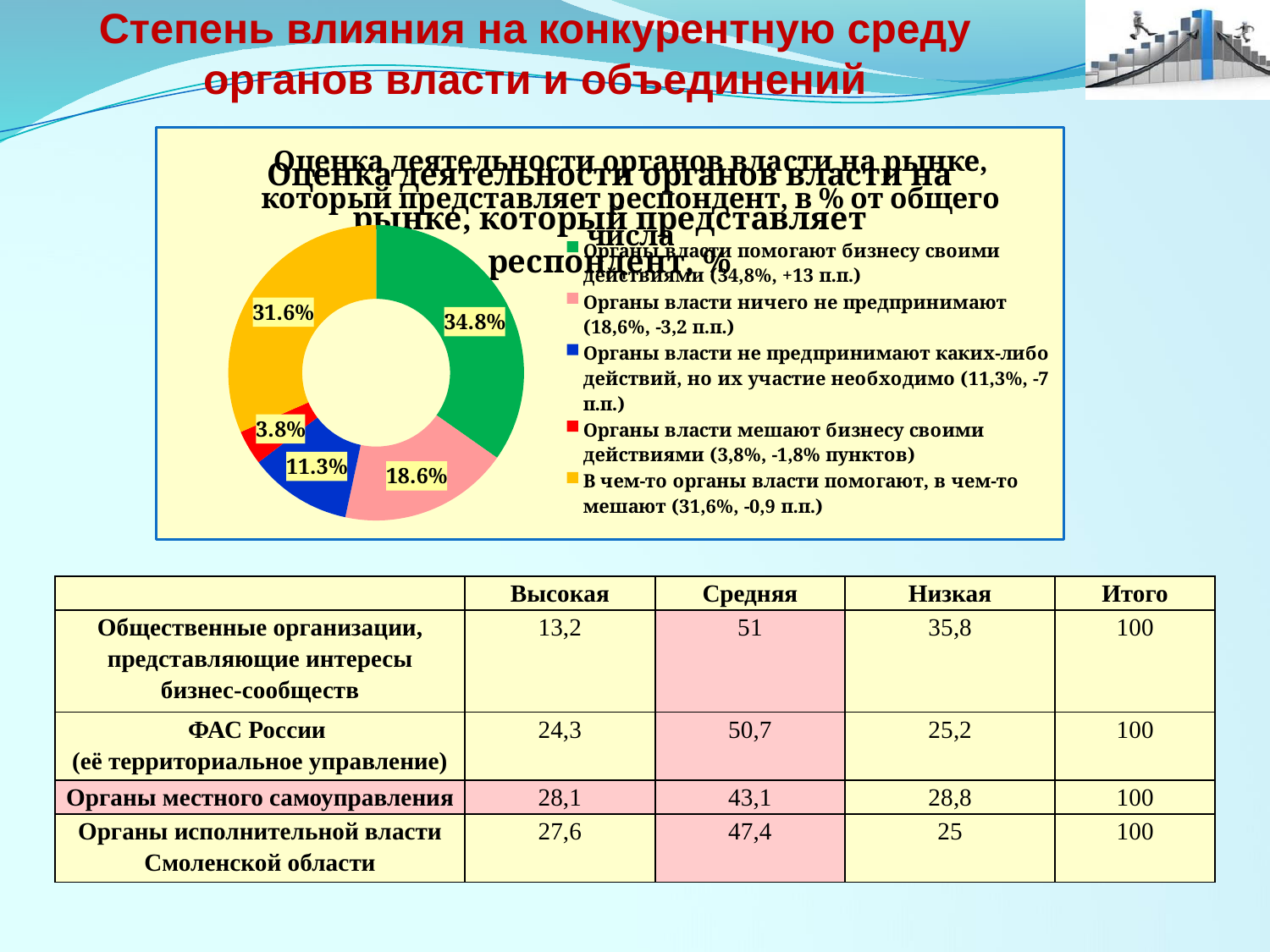
What is the value of the slice for 'Органы власти ничего не предпринимают'? 18.6% What colour is the slice for 'Органы власти не предпринимают каких-либо действий, но их участие необходимо'? blue Which is larger: the slice for 'Органы власти ничего не предпринимают' or the slice for 'Органы власти не предпринимают каких-либо действий, но их участие необходимо'? Органы власти ничего не предпринимают What is the value of the slice for 'В чем-то органы власти помогают, в чем-то мешают'? 31.6% Which category has the largest slice in the doughnut chart? Органы власти помогают бизнесу своими действиями What is the value of the slice for 'Органы власти помогают бизнесу своими действиями'? 34.8% Which category has the smallest slice in the doughnut chart? Органы власти мешают бизнесу своими действиями How many entries does the legend of the doughnut chart list? 5 What kind of chart is shown on the slide? doughnut (pie) chart What is the difference between the 34.8% slice and the 31.6% slice? 3.2 percentage points What is the value of the slice for 'Органы власти мешают бизнесу своими действиями'? 3.8% How many slices does the doughnut chart have? 5